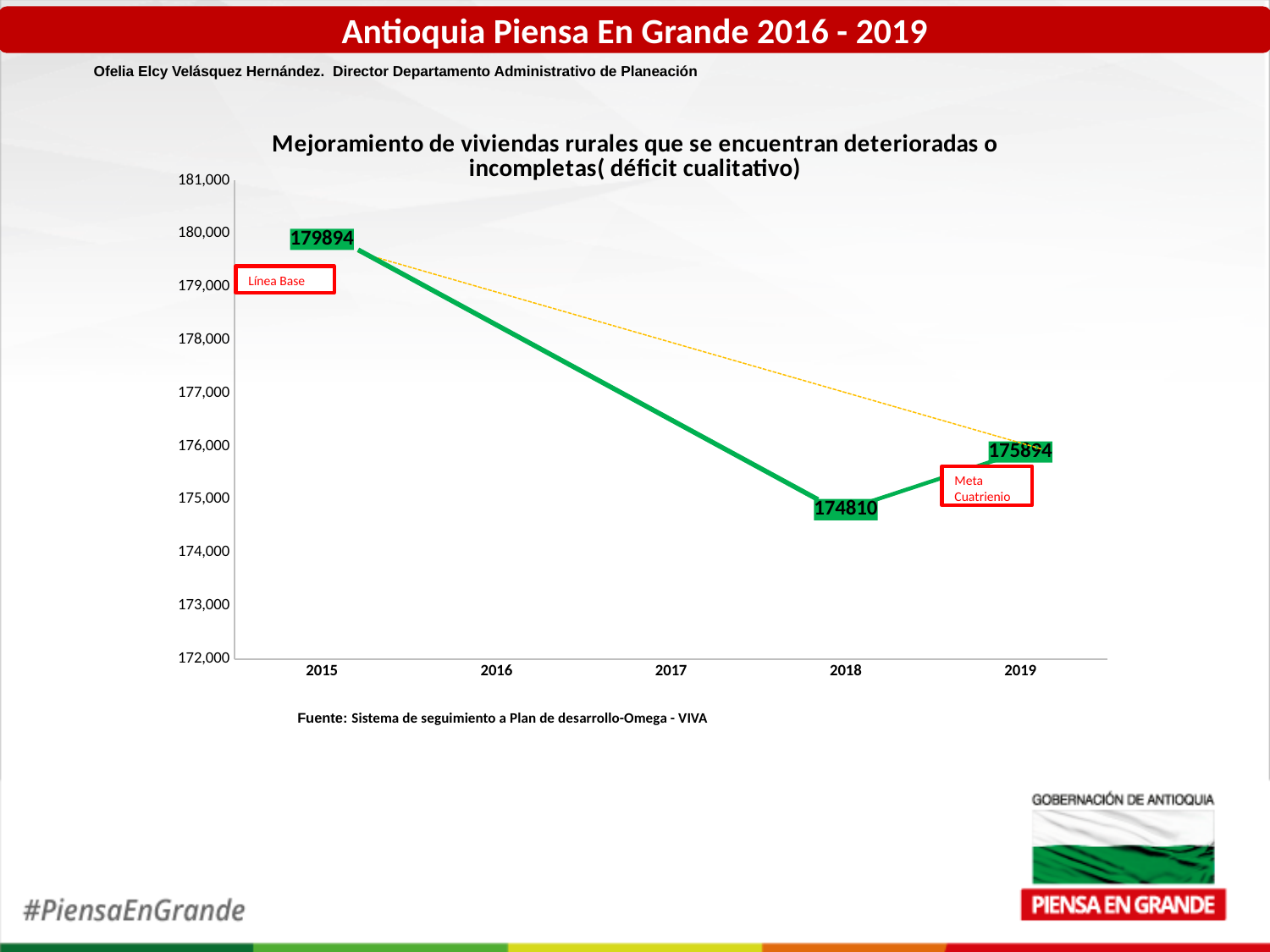
What is the value plotted for 2015? 179894 Which is larger, the value for 2015 or the value for 2018? 2015 Is the value for 2018 greater or less than 178,000? less Which year has the lowest plotted value? 2018 Which year has the highest plotted value? 2015 What is the value plotted for 2019? 175894 What kind of chart is shown on the slide? line chart Which annotation label is attached to the 2015 data point? Línea Base What is the difference between the values for 2015 and 2018? 5084 Does the plotted value rise or fall from 2015 to 2018? fall How many years are labeled on the x axis? 5 What is the value plotted for 2018? 174810